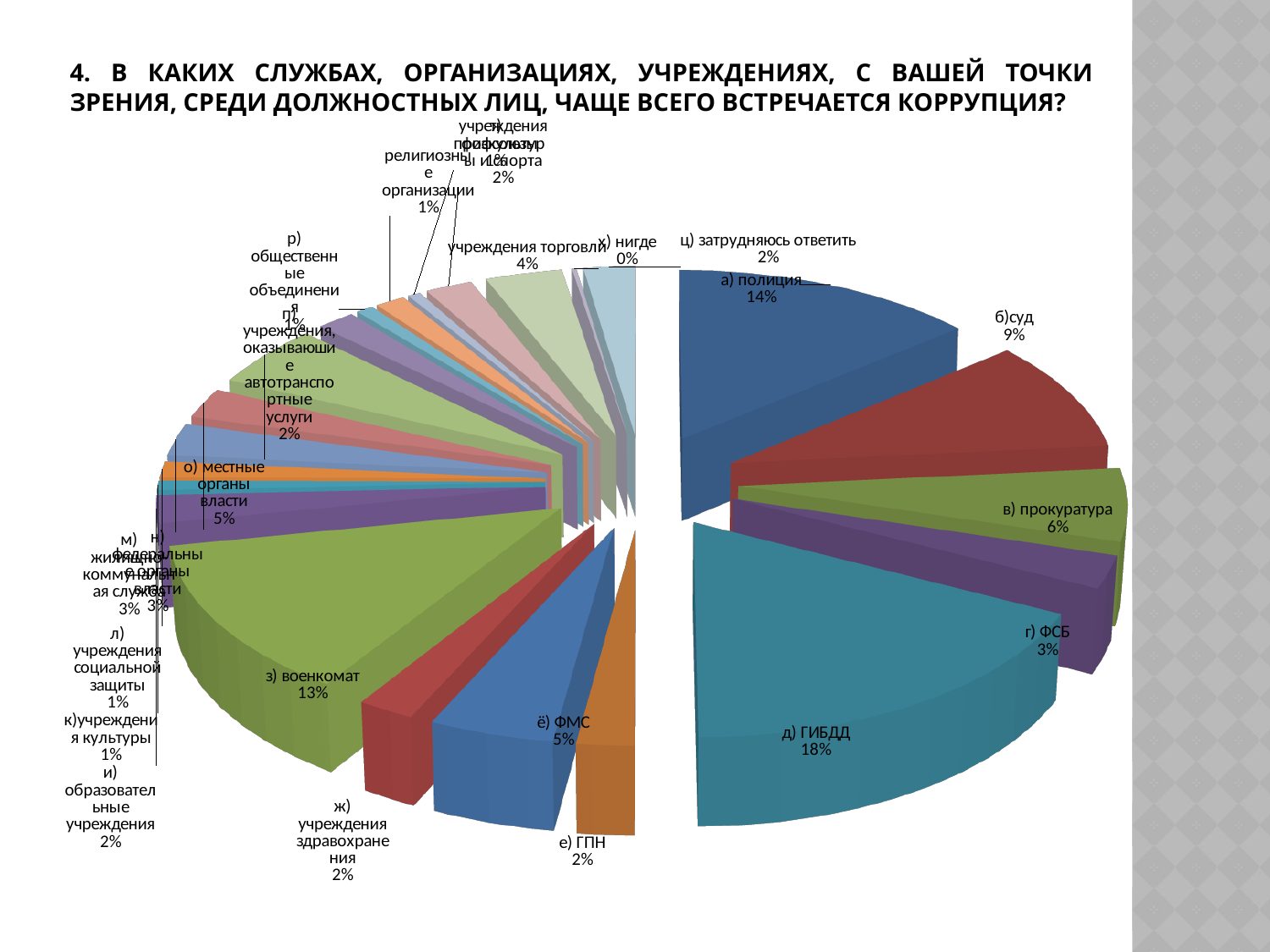
What is the value shown for о) местные органы власти? 5% What is the value shown for з) военкомат? 13% What is the difference between the shares of д) ГИБДД and а) полиция? 4% What is the value shown for а) полиция? 14% Which category has the smallest share, at 0%? х) нигде Which is larger, the share for а) полиция or the share for з) военкомат? а) полиция What is the value shown for в) прокуратура? 6% What is the value shown for ё) ФМС? 5% What share of the pie does д) ГИБДД account for? 18% What is the value shown for б)суд? 9% Which category has the largest slice of the pie? д) ГИБДД What type of chart is shown on the slide? Pie chart